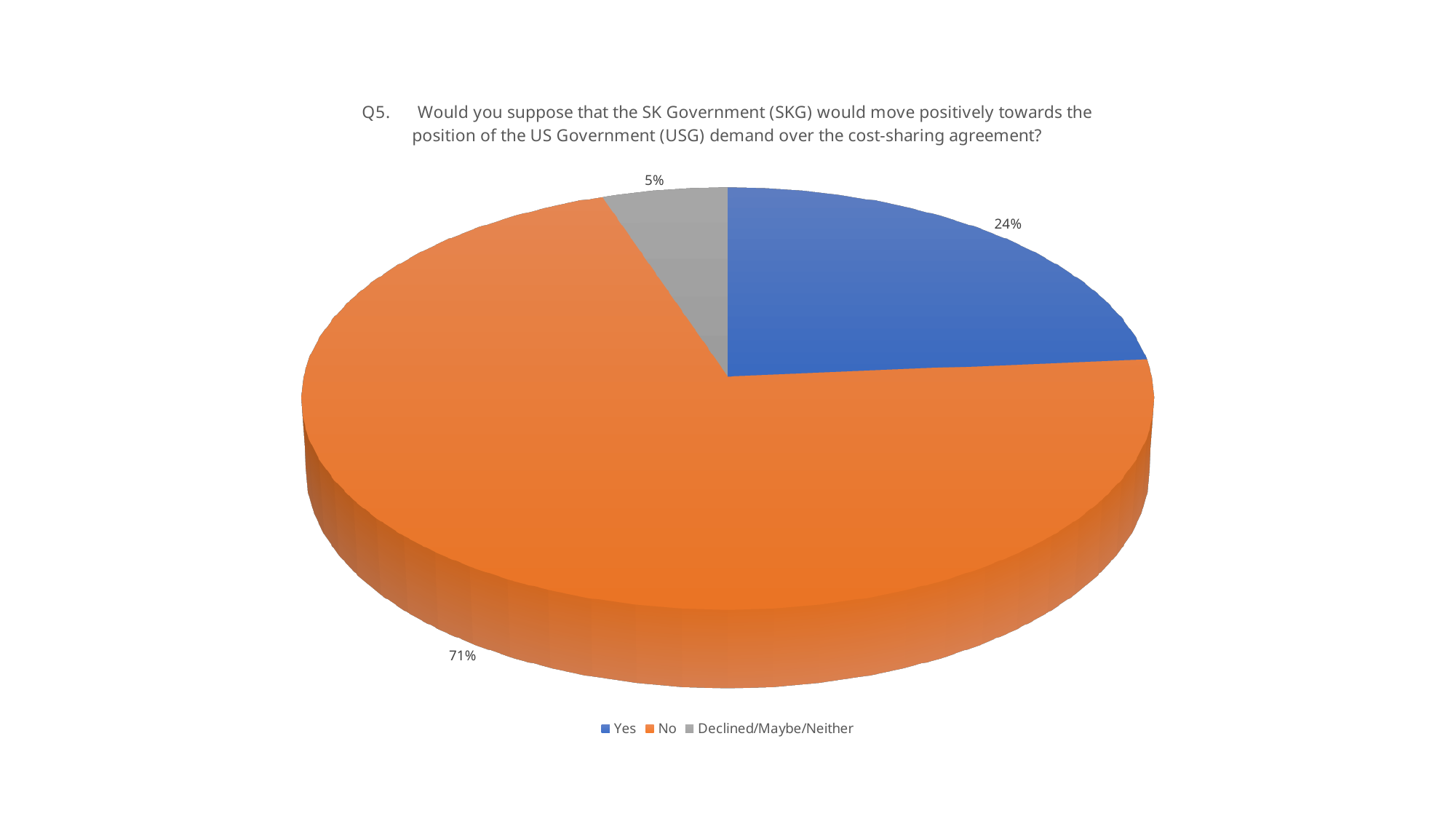
What kind of chart is shown on the slide? pie chart What percentage of respondents answered "No"? 71% Which response has the smallest share of the pie? Declined/Maybe/Neither What question number is shown in the chart title? Q5 What percentage of respondents answered "Yes"? 24% Which slice is larger, "Yes" or "Declined/Maybe/Neither"? Yes What colour is the "No" slice? orange What percentage of respondents answered "Declined/Maybe/Neither"? 5% What is the difference in percentage points between the "No" and "Yes" slices? 47 Which response has the largest share of the pie? No How many entries does the legend list? 3 How many slices does the pie chart have? 3